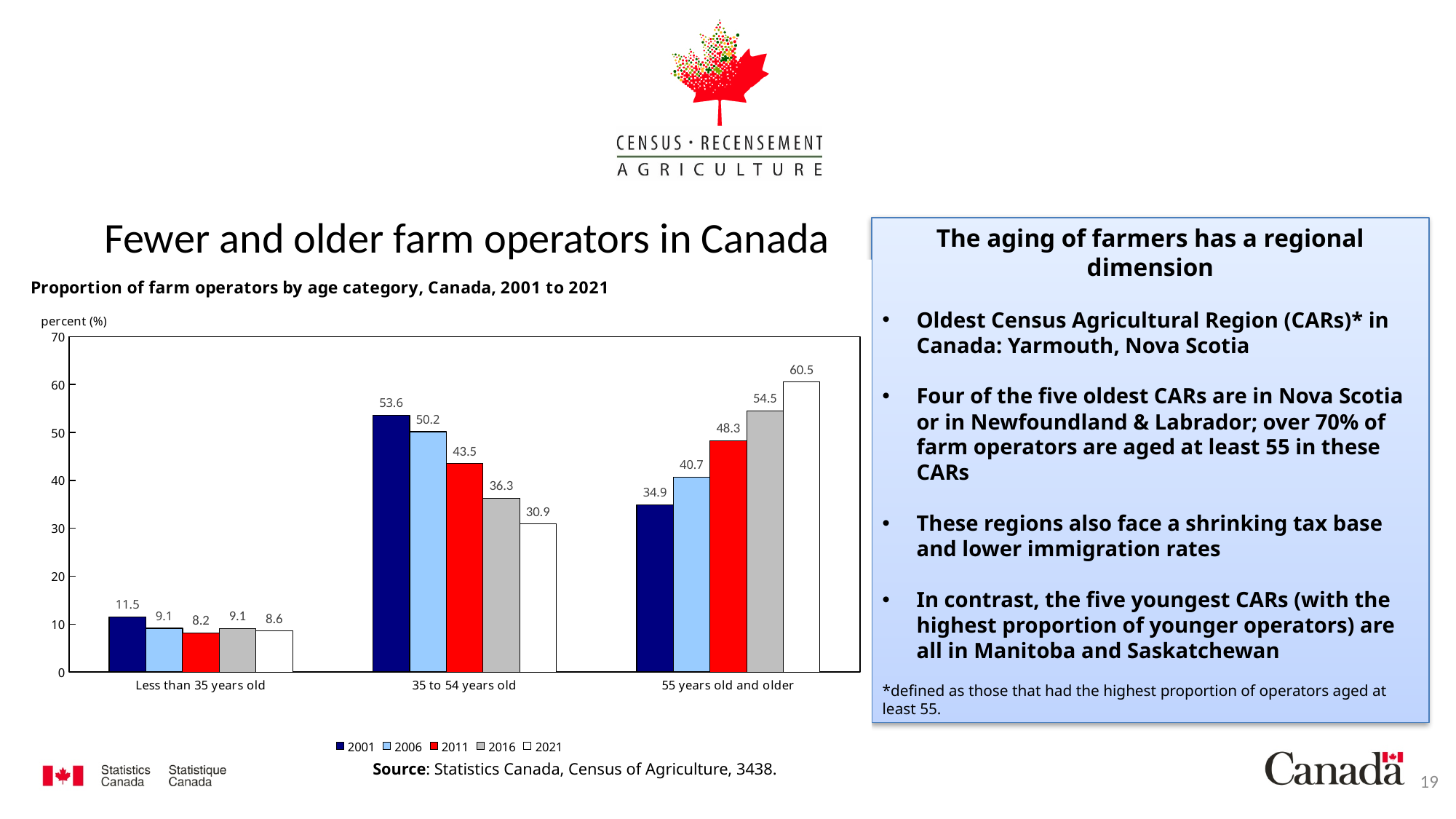
How many age categories are shown on the x axis? 3 Which is larger: the 2016 value for '35 to 54 years old' or the 2016 value for '55 years old and older'? 55 years old and older Which year has the highest value in the '55 years old and older' category? 2021 How many series does the legend list? 5 What is the value for 2001 in the '35 to 54 years old' category? 53.6 What is the value for 2011 in the 'Less than 35 years old' category? 8.2 Which year has the lowest value in the 'Less than 35 years old' category? 2011 What is the value for 2021 in the '55 years old and older' category? 60.5 How do the values for the '55 years old and older' category change from 2001 to 2021? They rise What is the difference between the 2001 and 2021 values in the '35 to 54 years old' category? 22.7 What type of chart is shown on the slide? Bar chart What is the title of the chart? Proportion of farm operators by age category, Canada, 2001 to 2021